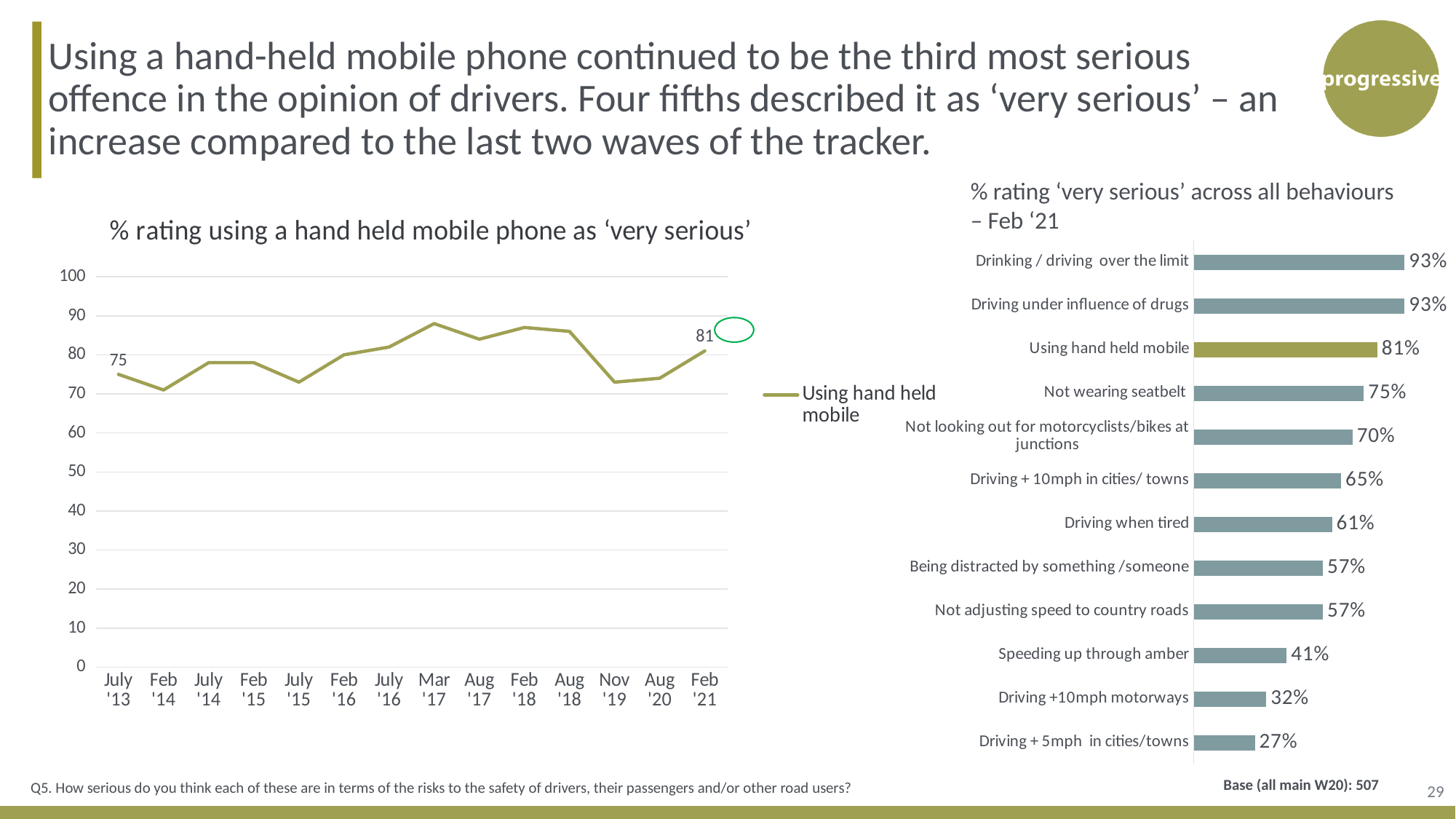
In the line chart '% rating using a hand held mobile phone as very serious', what is the value for July '13? 75 In the bar chart on the right, what percentage rated 'Not wearing seatbelt' as very serious? 75% What type of chart is the chart on the right, '% rating very serious across all behaviours – Feb 21'? bar chart In the bar chart on the right, which is larger: 'Speeding up through amber' or 'Driving +10mph motorways'? Speeding up through amber In the line chart on the left, is the value for Nov '19 greater or less than 80? less In the line chart on the left, what is the difference between the Feb '21 value and the July '13 value? 6 In the bar chart on the right, how many behaviours are listed? 12 In the bar chart on the right, what is the difference between 'Using hand held mobile' and 'Driving when tired'? 20% In the line chart on the left, how many time points are plotted along the x axis? 14 In the line chart '% rating using a hand held mobile phone as very serious', what is the value for Feb '21? 81 In the line chart on the left, is the value for Mar '17 greater or less than 80? greater In the bar chart on the right, which behaviour has the lowest percentage? Driving + 5mph in cities/towns